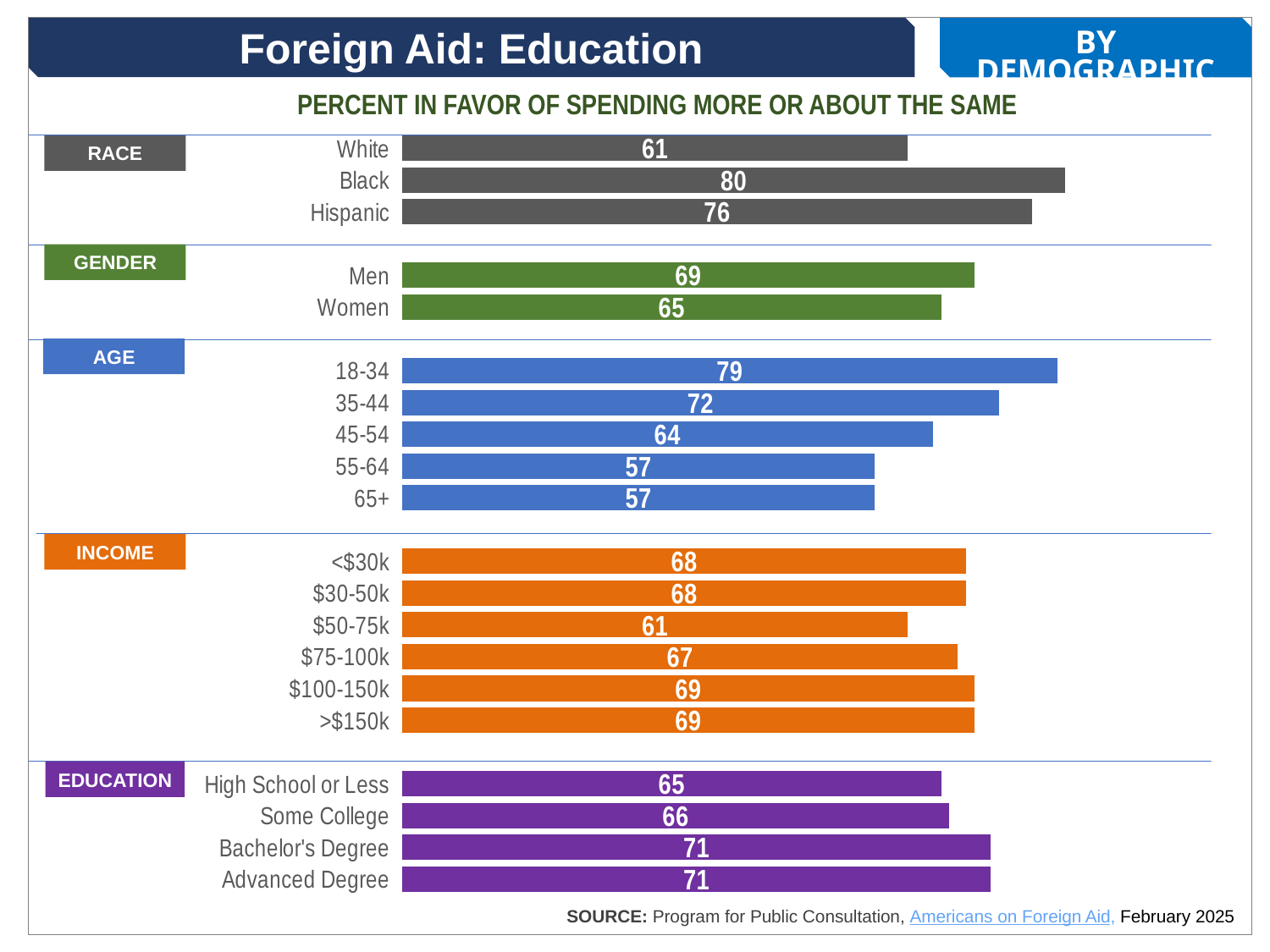
What kind of chart is shown on the slide? Bar chart Do the values rise or fall as age increases from 18-34 to 55-64? Fall What is the value shown for the 18-34 age group? 79 How many income categories are shown in the chart? 6 Which age group has the lowest value? 55-64 and 65+ Which race category has the highest value? Black What is the difference between the values for Men and Women? 4 Which has a higher value, Bachelor's Degree or Some College? Bachelor's Degree How many age groups are shown in the chart? 5 What percent of Black respondents are in favor of spending more or about the same on foreign aid for education? 80 What is the difference between the values for Black and White respondents? 19 What is the value shown for the $50-75k income group? 61